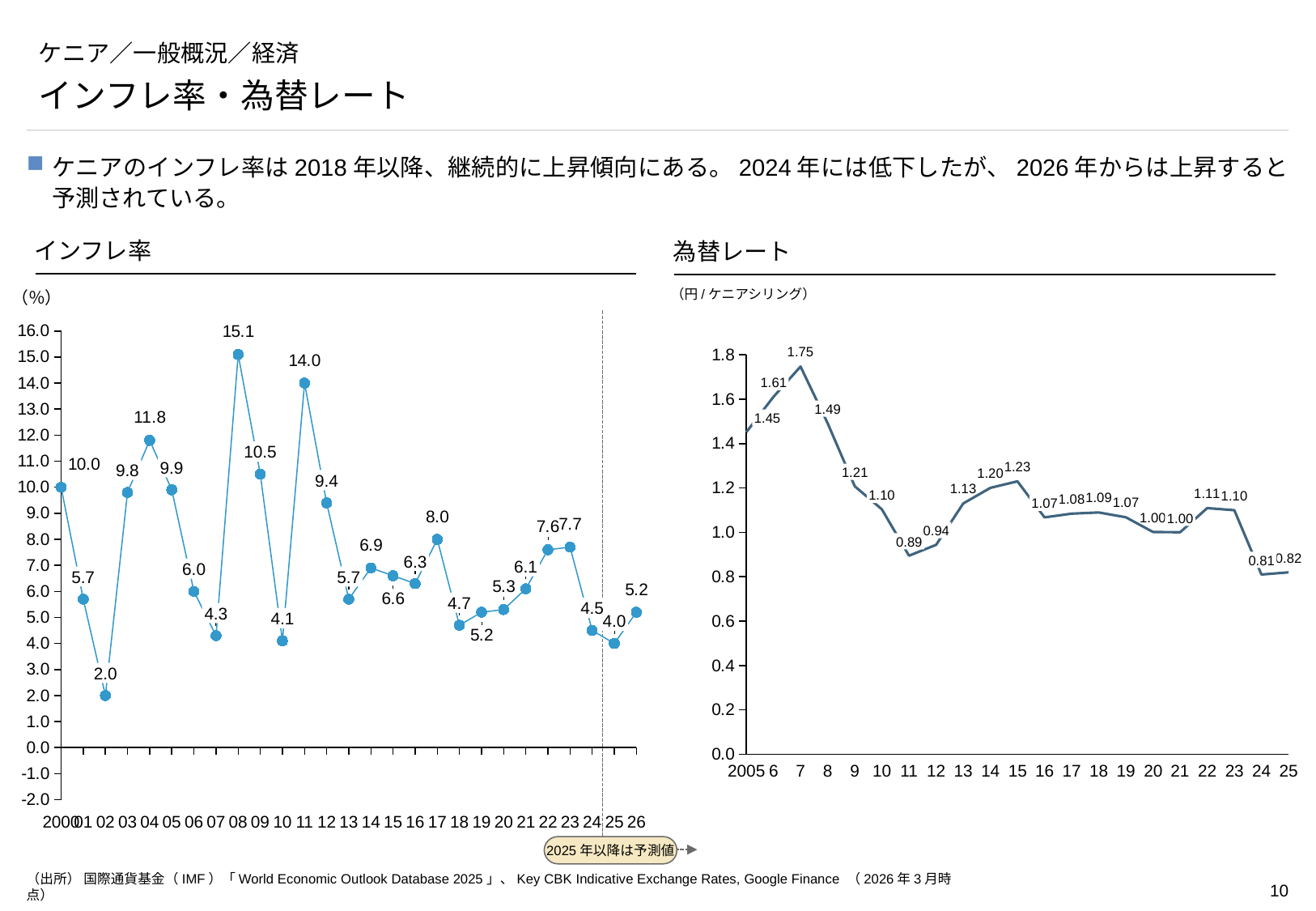
In the インフレ率 chart, which year has the lowest inflation rate? 2002 In the 為替レート chart, do the values rise or fall from 2022 to 2024? Fall In the インフレ率 chart, how many years are plotted? 27 In the インフレ率 chart, which year has the highest inflation rate? 2008 In the 為替レート chart, what is the value for 2007? 1.75 In the インフレ率 chart, what is the difference between the 2011 value and the 2010 value? 9.9 In the インフレ率 chart, what is the inflation rate for 2008? 15.1 What kind of chart is the 為替レート chart? Line chart In the インフレ率 chart, which is larger, the value for 2022 or the value for 2024? 2022 In the 為替レート chart, what is the difference between the 2007 value and the 2005 value? 0.30 In the 為替レート chart, which year has the lowest value? 2024 In the インフレ率 chart, what is the inflation rate for 2002? 2.0